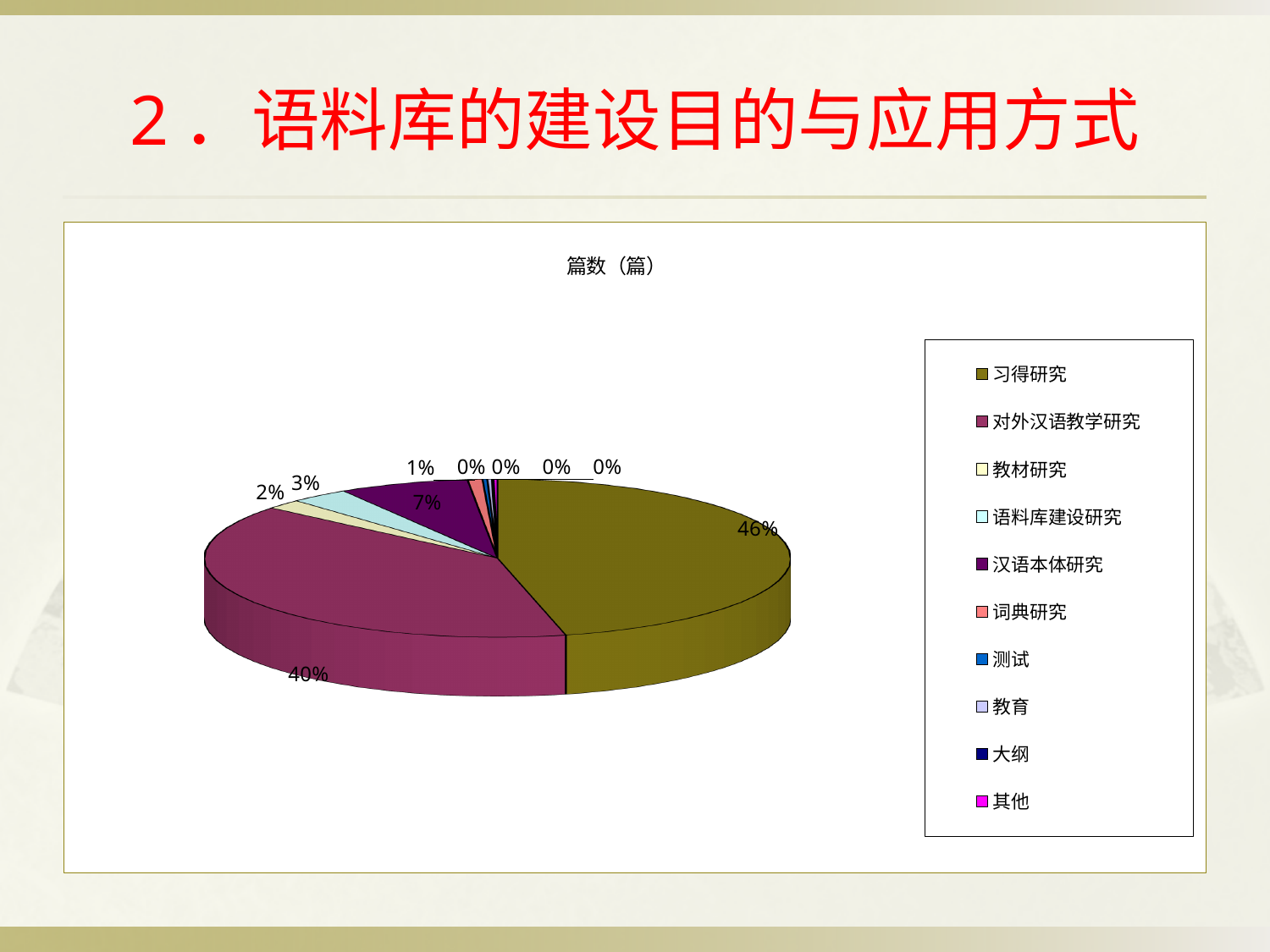
How many entries does the chart's legend list? 10 What kind of chart is shown on the slide? pie chart What share of the pie does 教材研究 account for? 2% What share of the pie does 语料库建设研究 account for? 3% Which category has the largest share of the pie? 习得研究 What share of the pie does 习得研究 account for? 46% Which has a larger share, 汉语本体研究 or 语料库建设研究? 汉语本体研究 What is the title of the chart? 篇数（篇） What is the difference in percentage points between the shares of 习得研究 and 对外汉语教学研究? 6%